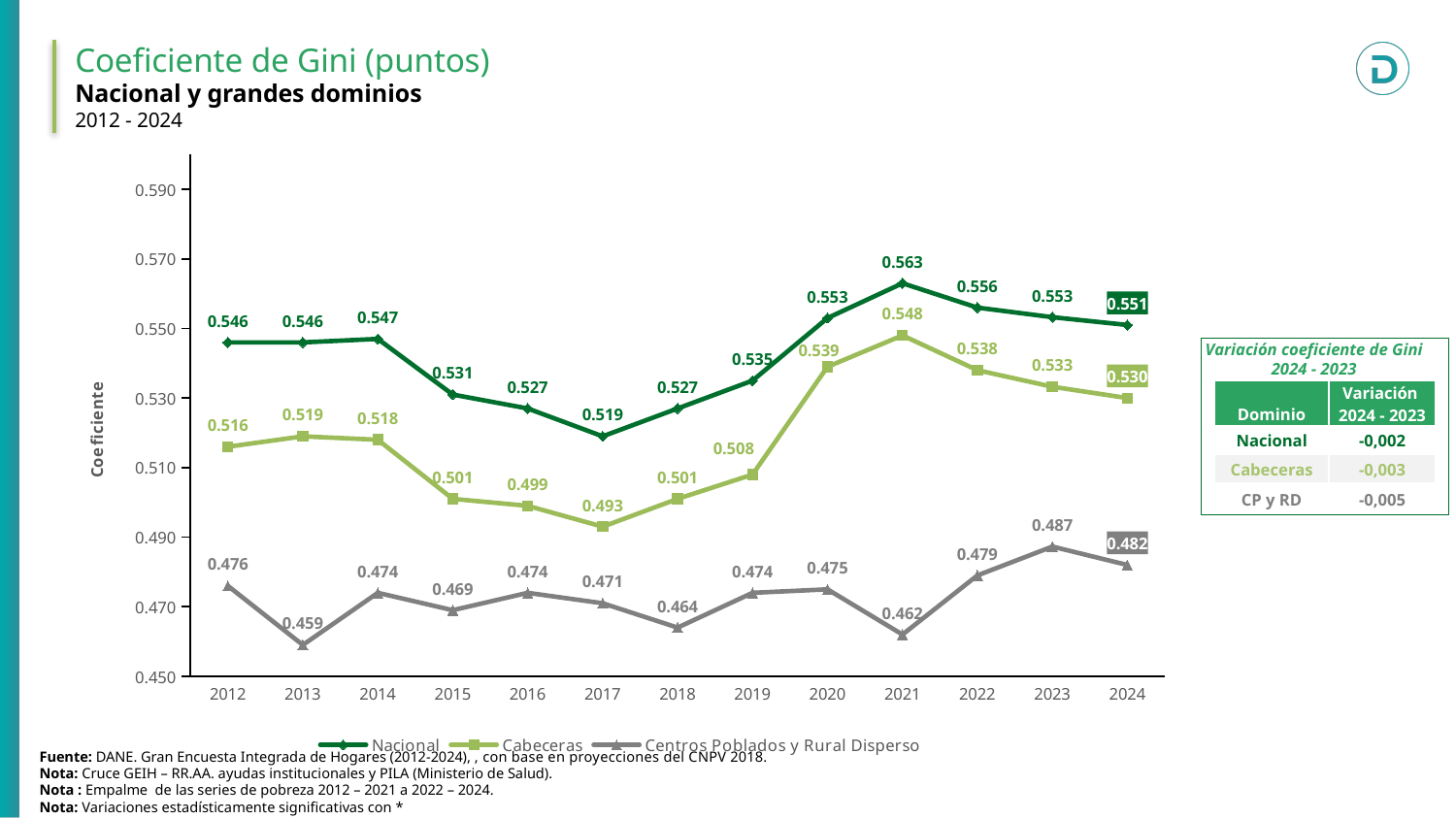
How many years are plotted on the x axis? 13 What is the value for Centros Poblados y Rural Disperso in 2013? 0.459 What is the Cabeceras value for 2017? 0.493 What type of chart is shown on the slide? Line chart Which series has the higher value in 2019, Nacional or Cabeceras? Nacional How many series does the chart legend list? 3 In which year does the Nacional series reach its highest value? 2021 What is the difference between the Nacional value and the Cabeceras value in 2024? 0.021 What is the Nacional Gini coefficient value for 2021? 0.563 According to the table on the slide, what is the 2024 - 2023 variation for Cabeceras? -0,003 In which year does the Centros Poblados y Rural Disperso series reach its lowest value? 2013 Does the Nacional series rise or fall from 2021 to 2024? Fall